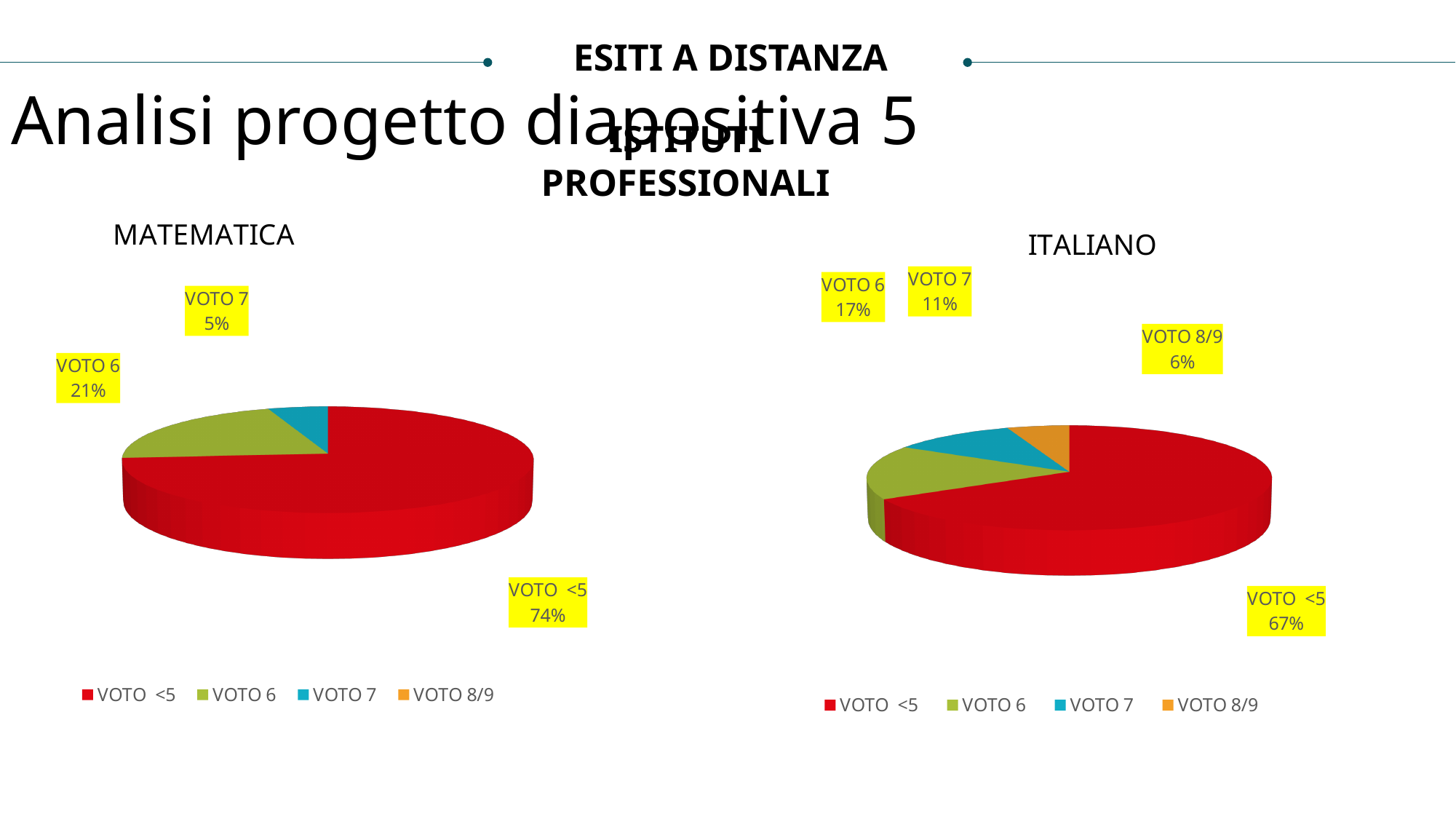
In the ITALIANO chart, what is the value for VOTO 8/9? 6% In the MATEMATICA chart, what is the difference between VOTO 6 and VOTO 7? 16% In the ITALIANO chart, which category has the largest slice? VOTO <5 In the MATEMATICA chart, what share of the pie is VOTO <5? 74% In the ITALIANO chart, what is the value for VOTO <5? 67% In the ITALIANO chart, which category has the smallest slice? VOTO 8/9 What kind of chart is the ITALIANO chart? Pie chart Which is larger: VOTO 6 in the MATEMATICA chart or VOTO 6 in the ITALIANO chart? MATEMATICA How many entries does the legend of the MATEMATICA chart list? 4 In the MATEMATICA chart, what is the value for VOTO 7? 5% In the ITALIANO chart, what is the value for VOTO 7? 11% In the MATEMATICA chart, what is the value for VOTO 6? 21%